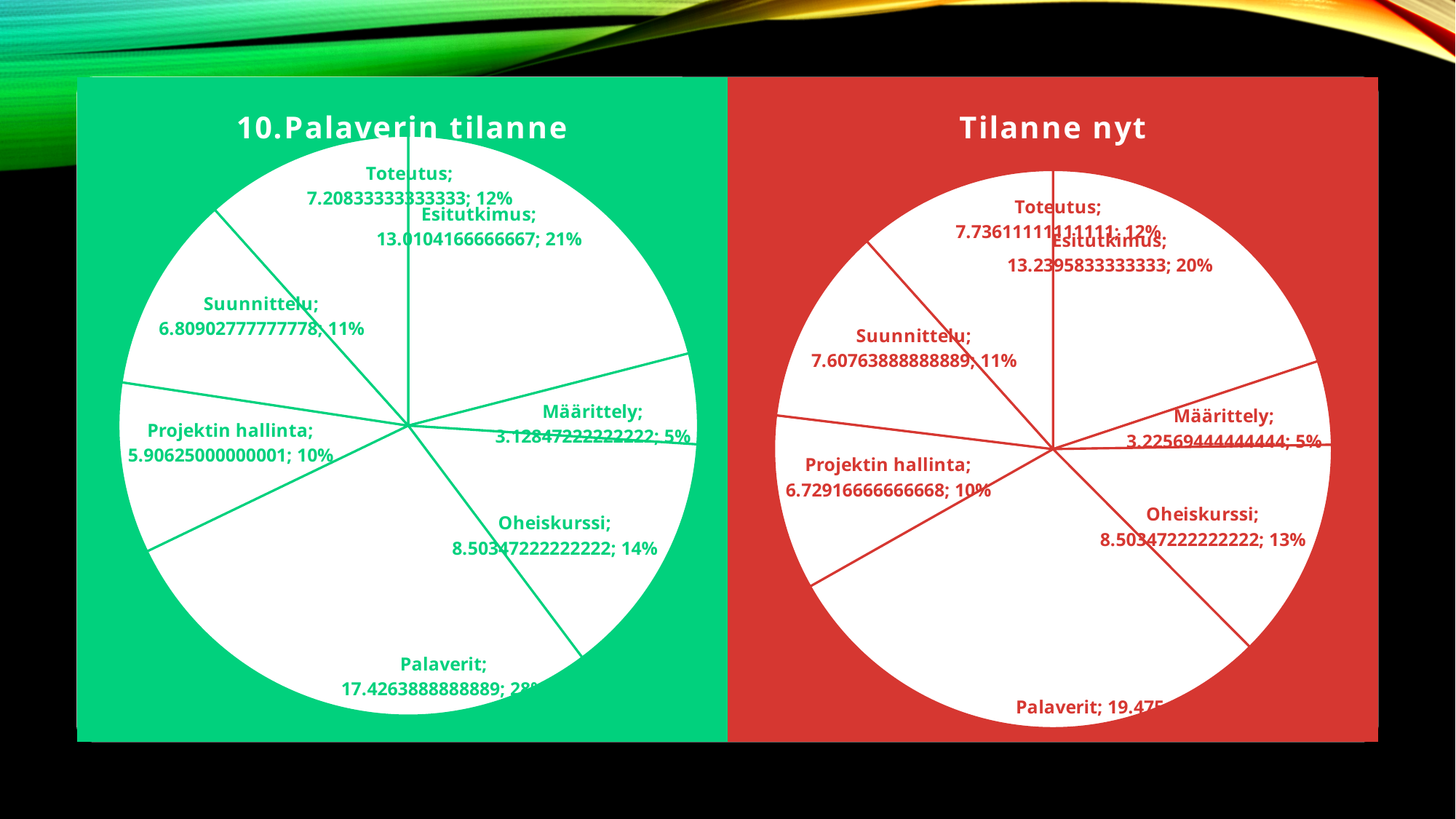
In the "10.Palaverin tilanne" chart, what share of the pie is Suunnittelu? 11% How many slices does the "Tilanne nyt" pie chart on the right have? 7 In the "10.Palaverin tilanne" chart, which is larger, Oheiskurssi or Toteutus? Oheiskurssi In the "Tilanne nyt" chart, which category has the largest slice? Palaverit In the "Tilanne nyt" chart, what share of the pie is Oheiskurssi? 13% What is the title of the pie chart on the right side of the slide? Tilanne nyt What kind of chart is the "10.Palaverin tilanne" chart on the left? pie chart In the "Tilanne nyt" chart, what is the difference in percentage points between the Esitutkimus share and the Määrittely share? 15% In the "10.Palaverin tilanne" chart, what is the value shown for Projektin hallinta? 5.90625000000001 In the "10.Palaverin tilanne" chart, which category has the smallest slice? Määrittely In the "Tilanne nyt" chart, what is the value shown for Suunnittelu? 7.60763888888889 In the "10.Palaverin tilanne" chart, what share of the pie is Esitutkimus? 21%